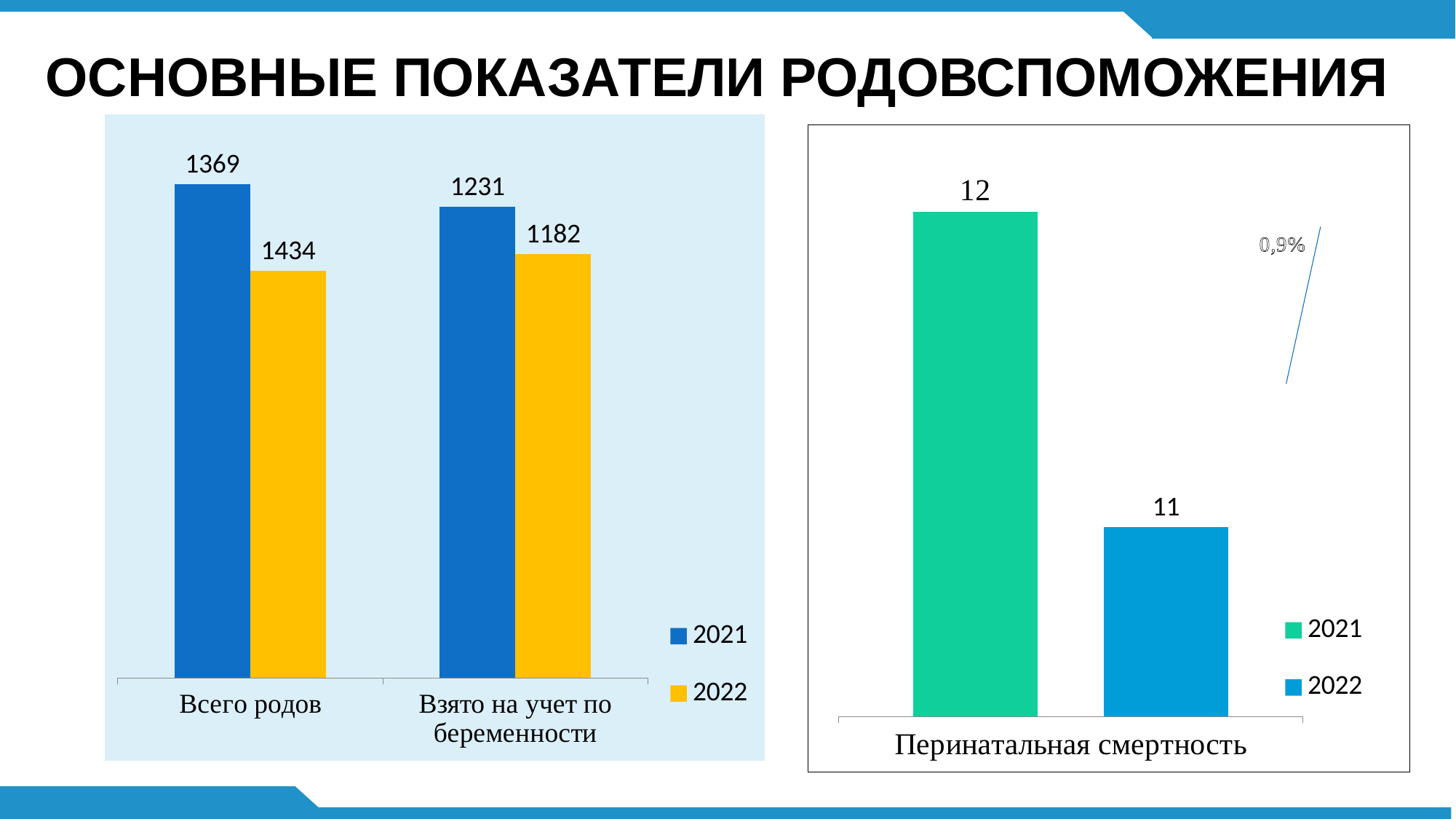
In the right chart, what is the value for 2022 for "Перинатальная смертность"? 11 In the left chart, how many series does the legend list? 2 In the right chart, what percentage is written in the annotation near the top right? 0,9% In the right chart, what is the value for 2021 for "Перинатальная смертность"? 12 In the left chart, what is the difference between the 2021 and 2022 values for "Взято на учет по беременности"? 49 In the left chart, what is the value for 2022 in the category "Взято на учет по беременности"? 1182 What kind of chart is the right chart? Bar chart In the right chart, which year has the higher value for "Перинатальная смертность"? 2021 In the left chart, what is the value for 2021 in the category "Всего родов"? 1369 In the left chart, how many categories are shown on the x axis? 2 In the left chart, what is the value for 2021 in the category "Взято на учет по беременности"? 1231 In the left chart, what is the value for 2022 in the category "Всего родов"? 1434